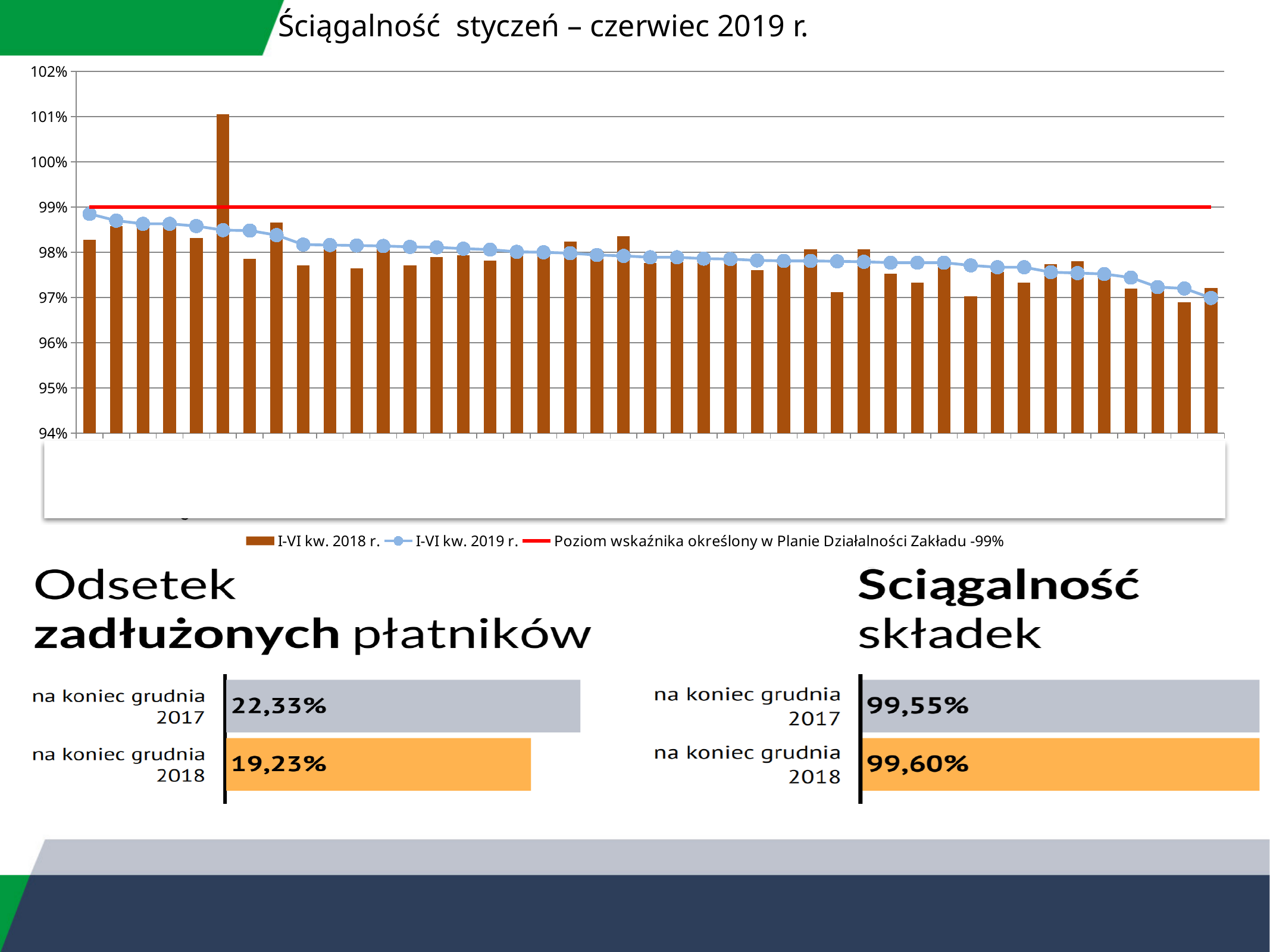
What kind of chart is the 'Odsetek zadłużonych płatników' chart? Bar chart In the 'Ściągalność składek' chart, what is the value for 'na koniec grudnia 2017'? 99,55% In the 'Ściągalność składek' chart, which period has the lower value? na koniec grudnia 2017 In the 'Ściągalność składek' chart, what is the value for 'na koniec grudnia 2018'? 99,60% How many series does the legend of the top chart 'Ściągalność styczeń – czerwiec 2019 r.' list? 3 In the 'Ściągalność składek' chart, what is the difference between the 2018 and 2017 values? 0,05 percentage points In the 'Odsetek zadłużonych płatników' chart, which period has the higher value, 'na koniec grudnia 2017' or 'na koniec grudnia 2018'? na koniec grudnia 2017 In the top chart 'Ściągalność styczeń – czerwiec 2019 r.', does the 'I-VI kw. 2019 r.' line rise or fall from left to right? Fall In the 'Odsetek zadłużonych płatników' chart, by how many percentage points did the value fall from 'na koniec grudnia 2017' to 'na koniec grudnia 2018'? 3,10 percentage points In the 'Odsetek zadłużonych płatników' chart, what is the value for 'na koniec grudnia 2018'? 19,23% In the 'Odsetek zadłużonych płatników' chart, what is the value for 'na koniec grudnia 2017'? 22,33% How many categories does the 'Ściągalność składek' chart show? 2